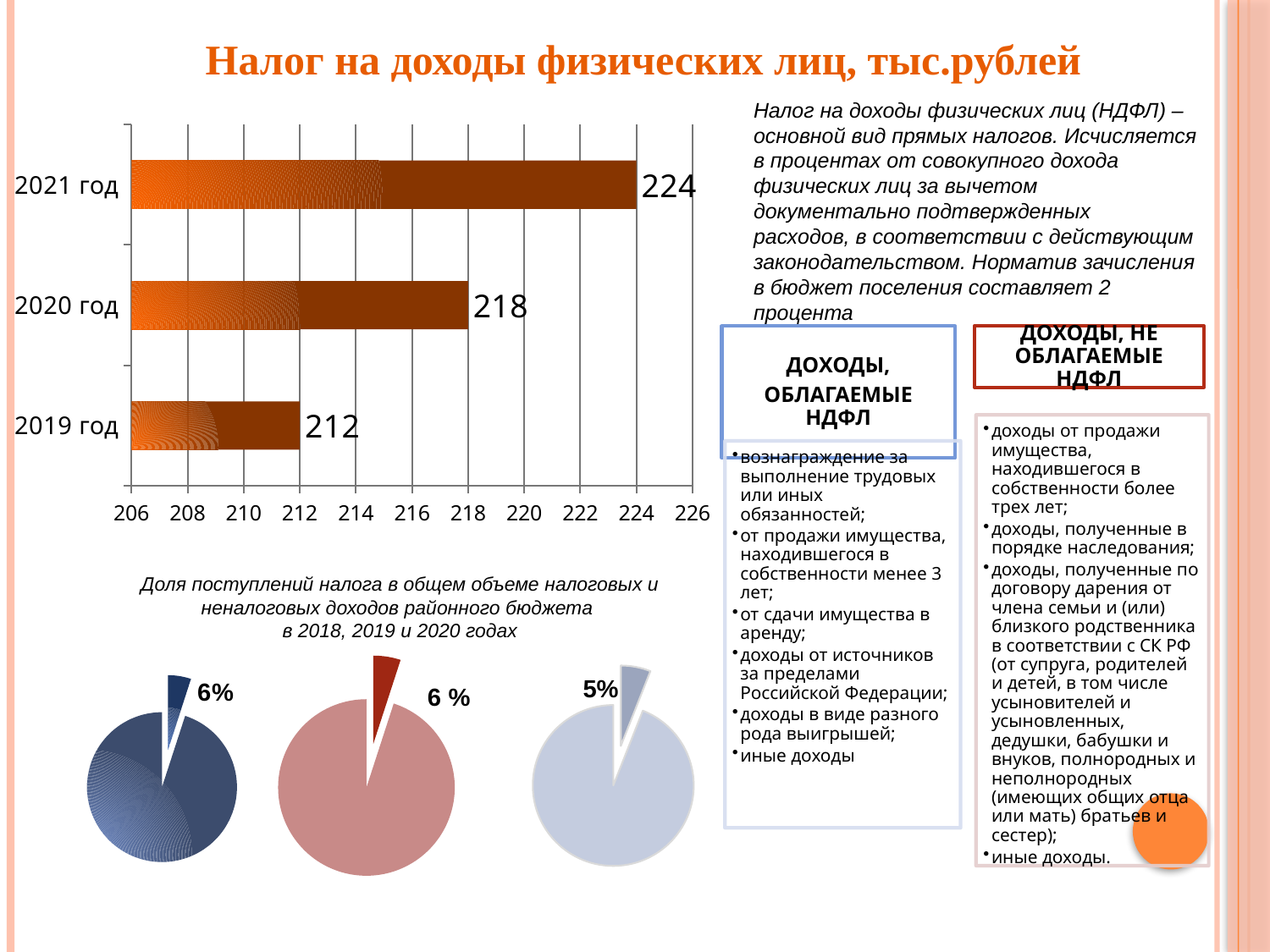
In the bar chart, what is the value for 2021 год? 224 In the bar chart, what is the difference between the values for 2021 год and 2019 год? 12 In the bar chart, what is the difference between the values for 2020 год and 2019 год? 6 What kind of chart is the chart at the top left of the slide? bar chart In the bar chart, which year has the lowest value? 2019 год In the bar chart, what is the value for 2019 год? 212 In the bar chart, which year has the highest value? 2021 год In the bar chart, do the values rise or fall from 2019 год to 2021 год? rise In the rightmost pie chart at the bottom of the slide, what share is shown for the small highlighted slice? 5% In the bar chart, what is the value for 2020 год? 218 In the bar chart, how many years are shown? 3 In the bar chart, which is larger, the value for 2020 год or 2021 год? 2021 год